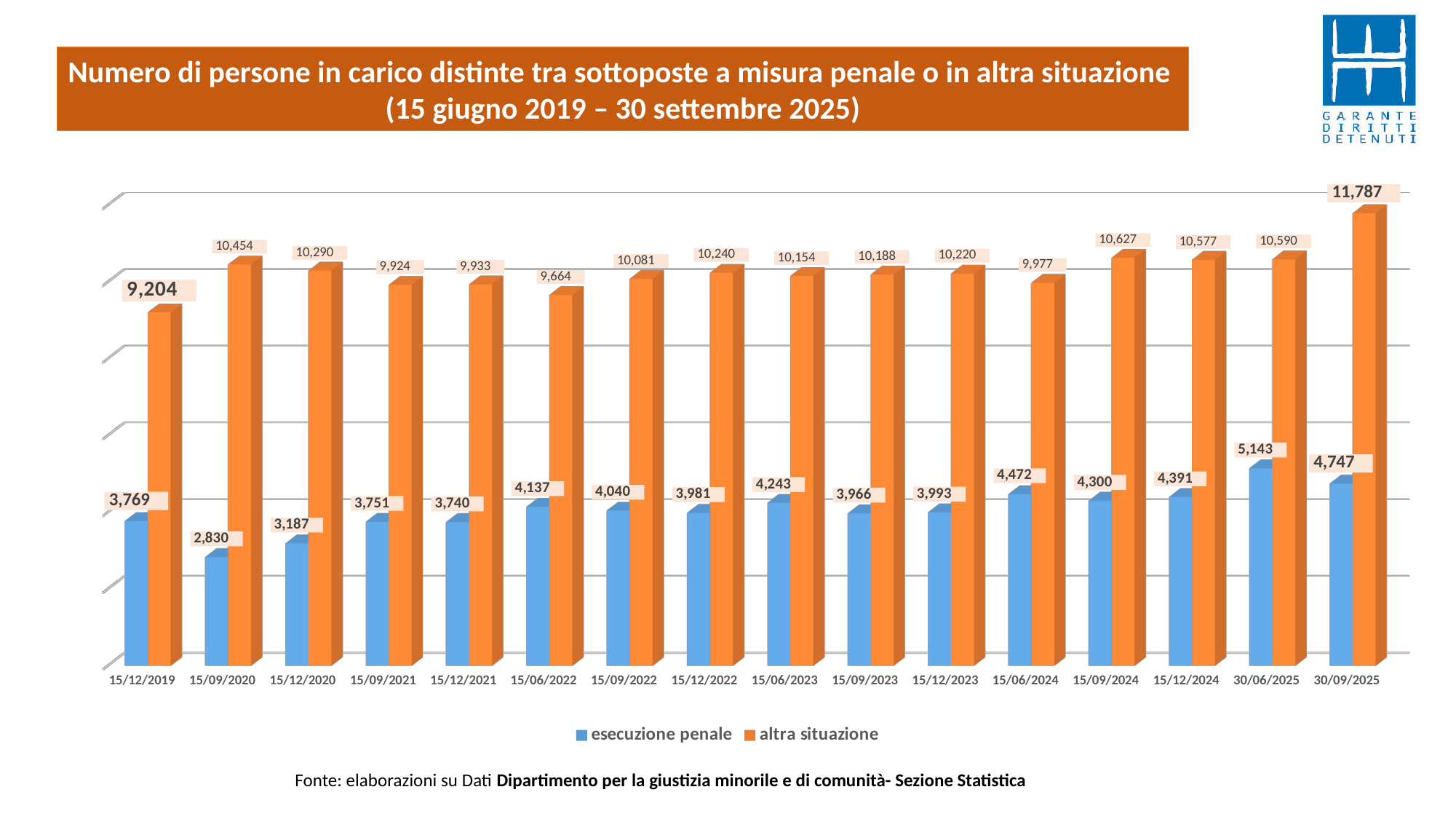
What kind of chart is shown on the slide? bar chart What is the value for altra situazione on 15/06/2022? 9,664 On which date is the esecuzione penale value highest? 30/06/2025 What is the difference between altra situazione and esecuzione penale on 30/09/2025? 7,040 How many series does the legend list? 2 What is the value for altra situazione on 30/09/2025? 11,787 What is the value for esecuzione penale on 15/12/2019? 3,769 What is the value for esecuzione penale on 15/06/2024? 4,472 How many dates are shown on the x axis? 16 On which date is the altra situazione value highest? 30/09/2025 On which date is the esecuzione penale value lowest? 15/09/2020 Which is larger: esecuzione penale on 15/12/2020 or on 15/09/2021? 15/09/2021